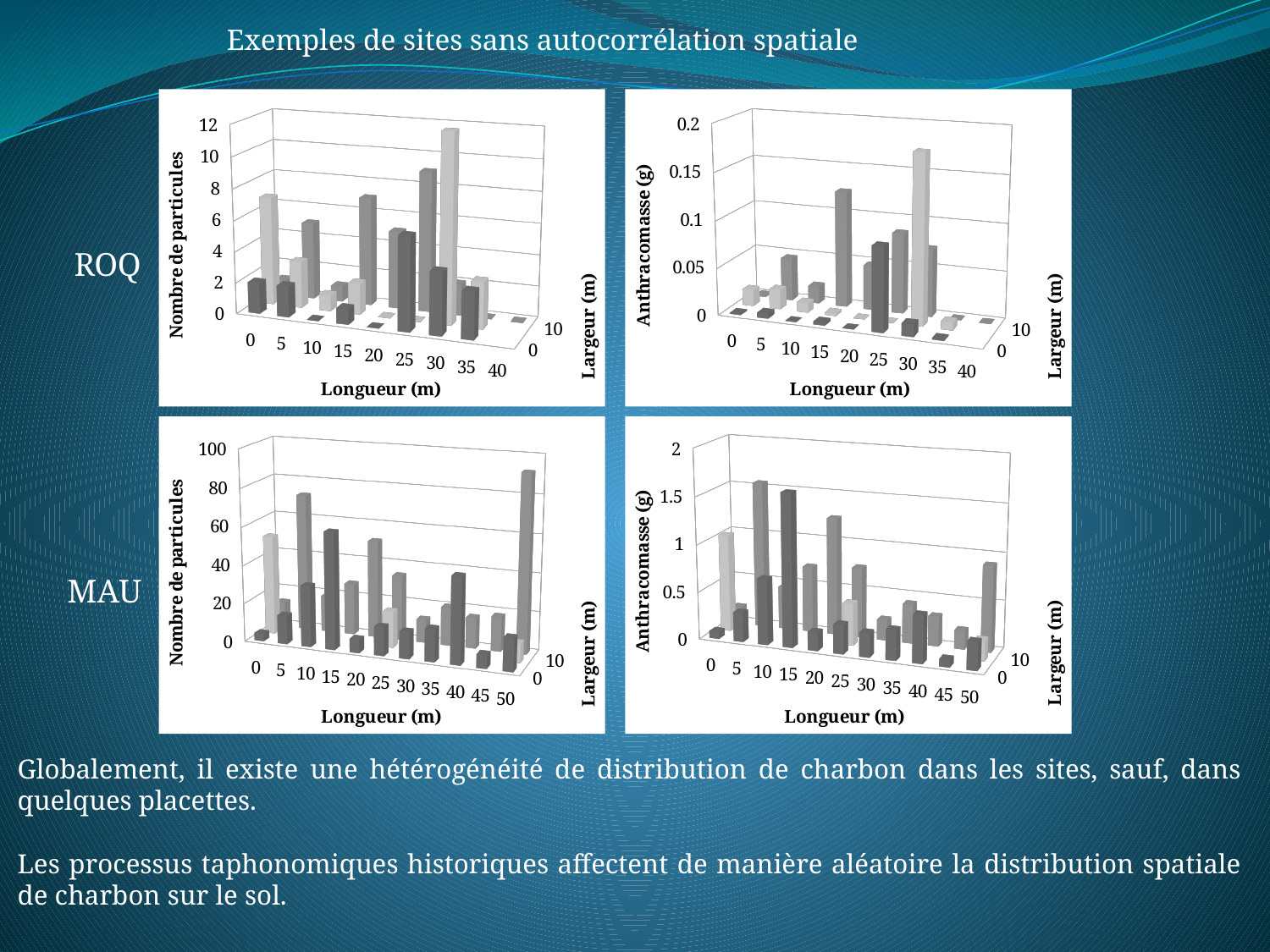
What kind of chart is the top-left chart (ROQ, Nombre de particules)? bar chart On the bottom-left chart (MAU, Nombre de particules), how many Longueur (m) tick labels are shown along the x axis? 11 On the bottom-left chart (MAU, Nombre de particules), is the tallest bar greater or less than 60? greater On the top-right chart (ROQ, Anthracomasse), is the tallest bar greater or less than 0.1? greater How many charts are shown on the slide? 4 On the top-left chart (ROQ, Nombre de particules), is the tallest bar greater or less than 6? greater On the bottom-left chart (MAU, Nombre de particules), what is the highest value shown on the vertical axis? 100 On the top-left chart (ROQ, Nombre de particules), what is the title of the vertical axis? Nombre de particules On the top-right chart (ROQ, Anthracomasse), what is the title of the vertical axis? Anthracomasse (g) On the top-left chart (ROQ, Nombre de particules), how many Longueur (m) tick labels are shown along the x axis? 9